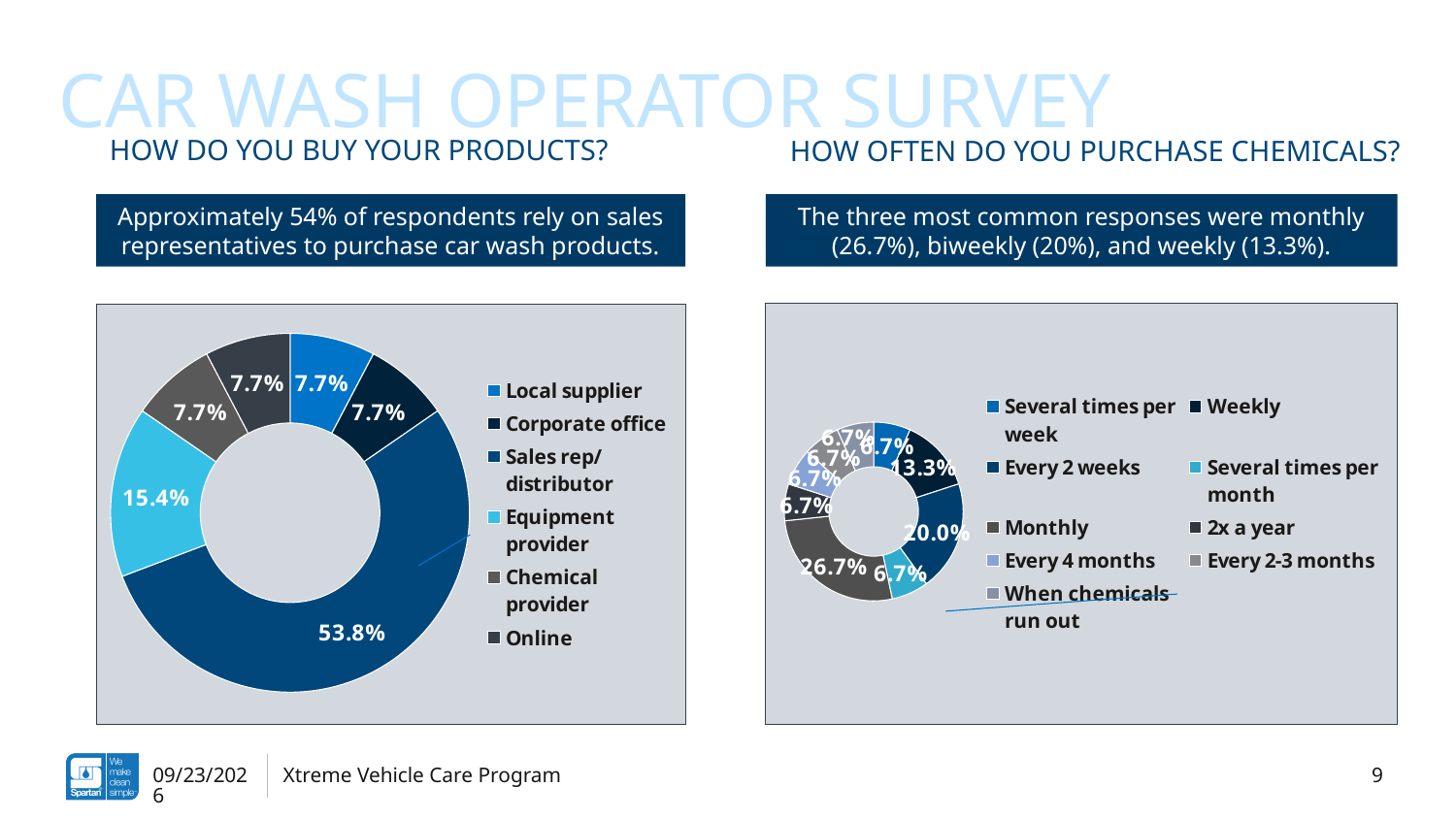
In the 'How often do you purchase chemicals?' chart, what percentage is shown for Every 2 weeks? 20.0% In the 'How do you buy your products?' chart, what percentage is shown for Equipment provider? 15.4% In the 'How often do you purchase chemicals?' chart, which response has the largest share? Monthly In the 'How often do you purchase chemicals?' chart, which is larger: the share for Every 2 weeks or the share for Weekly? Every 2 weeks In the 'How often do you purchase chemicals?' chart, what percentage is shown for Weekly? 13.3% How many categories does the legend of the 'How do you buy your products?' chart list? 6 In the 'How do you buy your products?' chart, what percentage is shown for Sales rep/distributor? 53.8% In the 'How do you buy your products?' chart, what is the difference between the Sales rep/distributor share and the Equipment provider share? 38.4% How many categories does the legend of the 'How often do you purchase chemicals?' chart list? 9 What type of chart is used on the left side of the slide for 'How do you buy your products?' Donut (pie) chart In the 'How often do you purchase chemicals?' chart, what percentage is shown for Monthly? 26.7% In the 'How do you buy your products?' chart, which category has the largest share? Sales rep/distributor